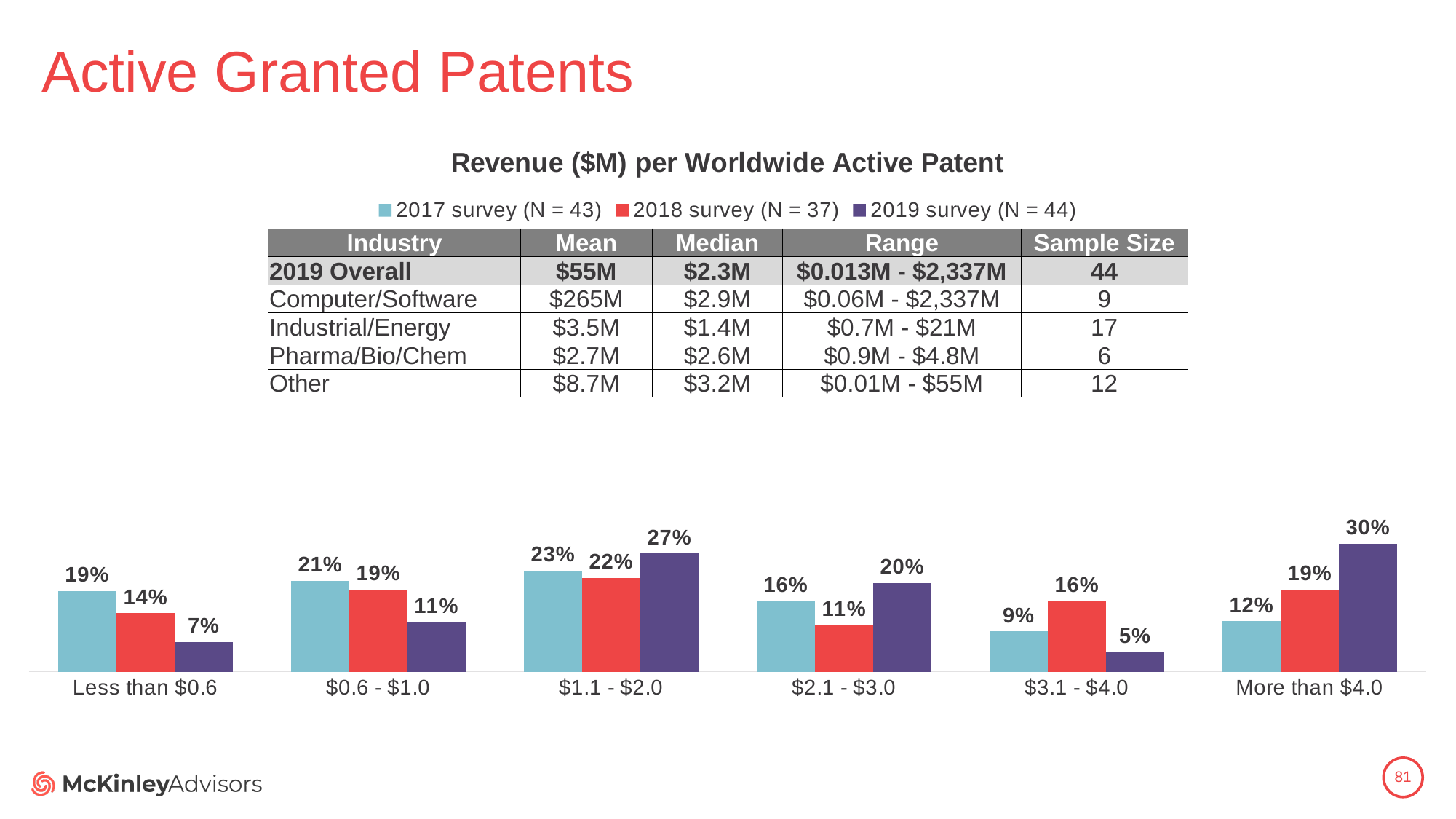
What kind of chart is shown on the slide? Bar chart What is the value for the 2017 survey in the 'Less than $0.6' category? 19% What is the value for the 2018 survey in the '$3.1 - $4.0' category? 16% What is the sample size (N) for the 2018 survey according to the legend? 37 How many series does the legend list? 3 What is the difference between the 2019 survey and 2017 survey values in the '$1.1 - $2.0' category? 4% How many categories are shown on the x axis of the bar chart? 6 What is the title of the chart? Revenue ($M) per Worldwide Active Patent In the '$2.1 - $3.0' category, which is larger: the 2017 survey value or the 2018 survey value? 2017 survey Which category has the lowest value for the 2017 survey? $3.1 - $4.0 What is the value for the 2019 survey in the 'More than $4.0' category? 30% Which category has the highest value for the 2019 survey? More than $4.0